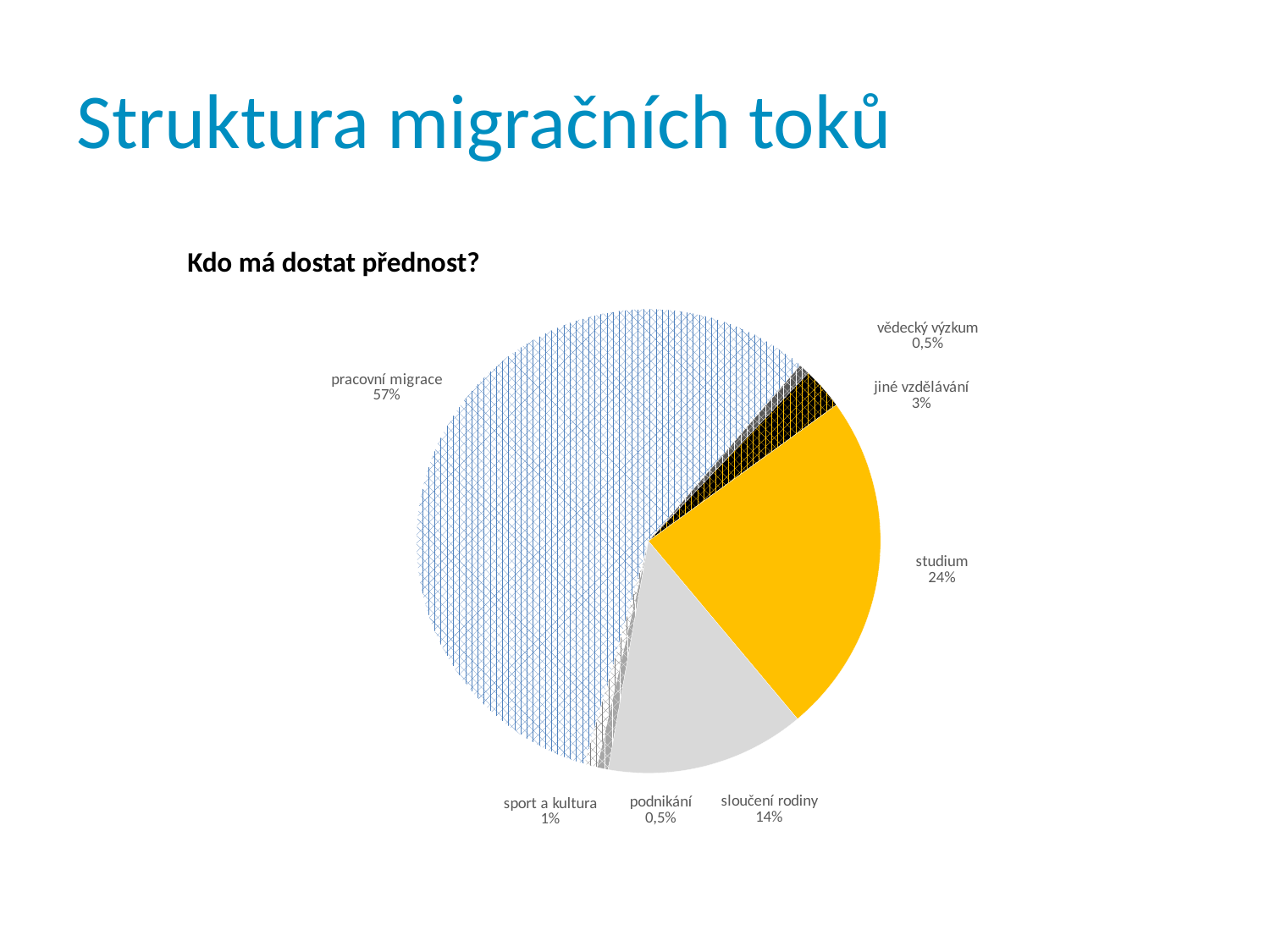
What percentage is shown for sloučení rodiny? 14% What kind of chart is shown on the slide? pie chart What is the difference between the shares of pracovní migrace and studium? 33% What is the value shown for jiné vzdělávání? 3% How many slices does the pie chart have? 7 Which is larger, the share for studium or the share for sloučení rodiny? studium What share of the pie does pracovní migrace have? 57% What is the value shown for sport a kultura? 1% What is the value shown for studium? 24% What is the title shown above the pie chart? Kdo má dostat přednost? What percentage is shown for vědecký výzkum? 0,5% Which category has the largest slice of the pie? pracovní migrace